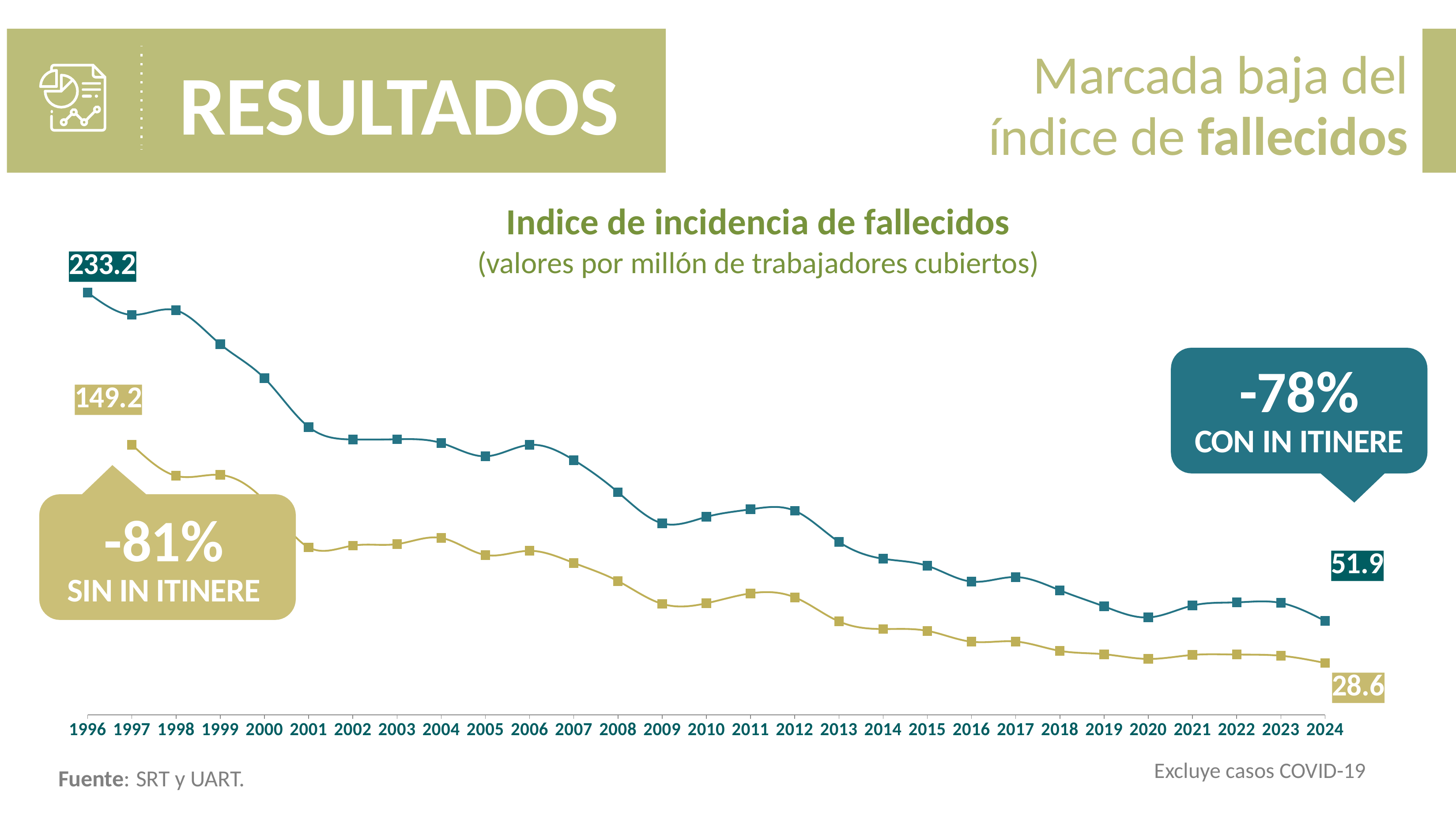
Do the values of the SIN IN ITINERE series generally rise or fall from 1996 to 2024? Fall What is the title of the chart? Indice de incidencia de fallecidos What is the value of the CON IN ITINERE series in 1996? 233.2 What is the value of the SIN IN ITINERE series in 2024? 28.6 How many years are shown on the x axis? 29 What kind of chart is shown on the slide? Line chart What is the value of the CON IN ITINERE series in 2024? 51.9 What is the difference between the 1996 and 2024 values of the CON IN ITINERE series? 181.3 In which year does the CON IN ITINERE series reach its highest value? 1996 Which series has the higher value in 2024, CON IN ITINERE or SIN IN ITINERE? CON IN ITINERE